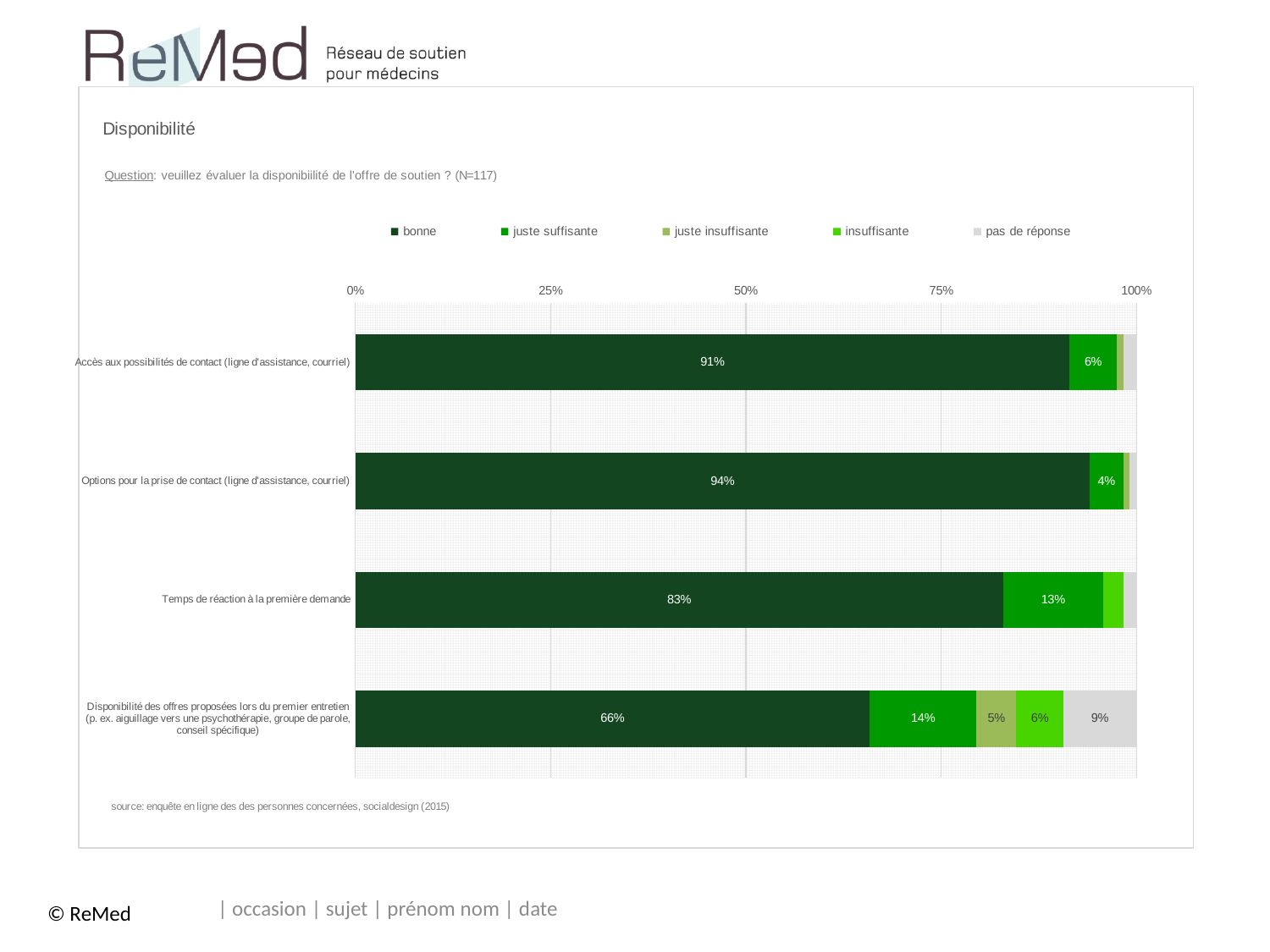
Which category has the highest 'bonne' value? Options pour la prise de contact (ligne d'assistance, courriel) Which category has the lowest 'bonne' value? Disponibilité des offres proposées lors du premier entretien Is the 'bonne' value for 'Disponibilité des offres proposées lors du premier entretien' greater or less than 75%? less How many series does the legend list? 5 How many categories are plotted on the chart? 4 What is the 'bonne' value for 'Temps de réaction à la première demande'? 83% Which is larger: the 'juste suffisante' value for 'Temps de réaction à la première demande' or for 'Accès aux possibilités de contact'? Temps de réaction à la première demande What is the 'juste suffisante' value for 'Disponibilité des offres proposées lors du premier entretien'? 14% What kind of chart is shown on the slide? stacked bar chart What is the 'bonne' value for 'Options pour la prise de contact (ligne d'assistance, courriel)'? 94% What is the 'pas de réponse' value for 'Disponibilité des offres proposées lors du premier entretien'? 9% What is the difference between the 'bonne' values for 'Accès aux possibilités de contact' and 'Temps de réaction à la première demande'? 8%